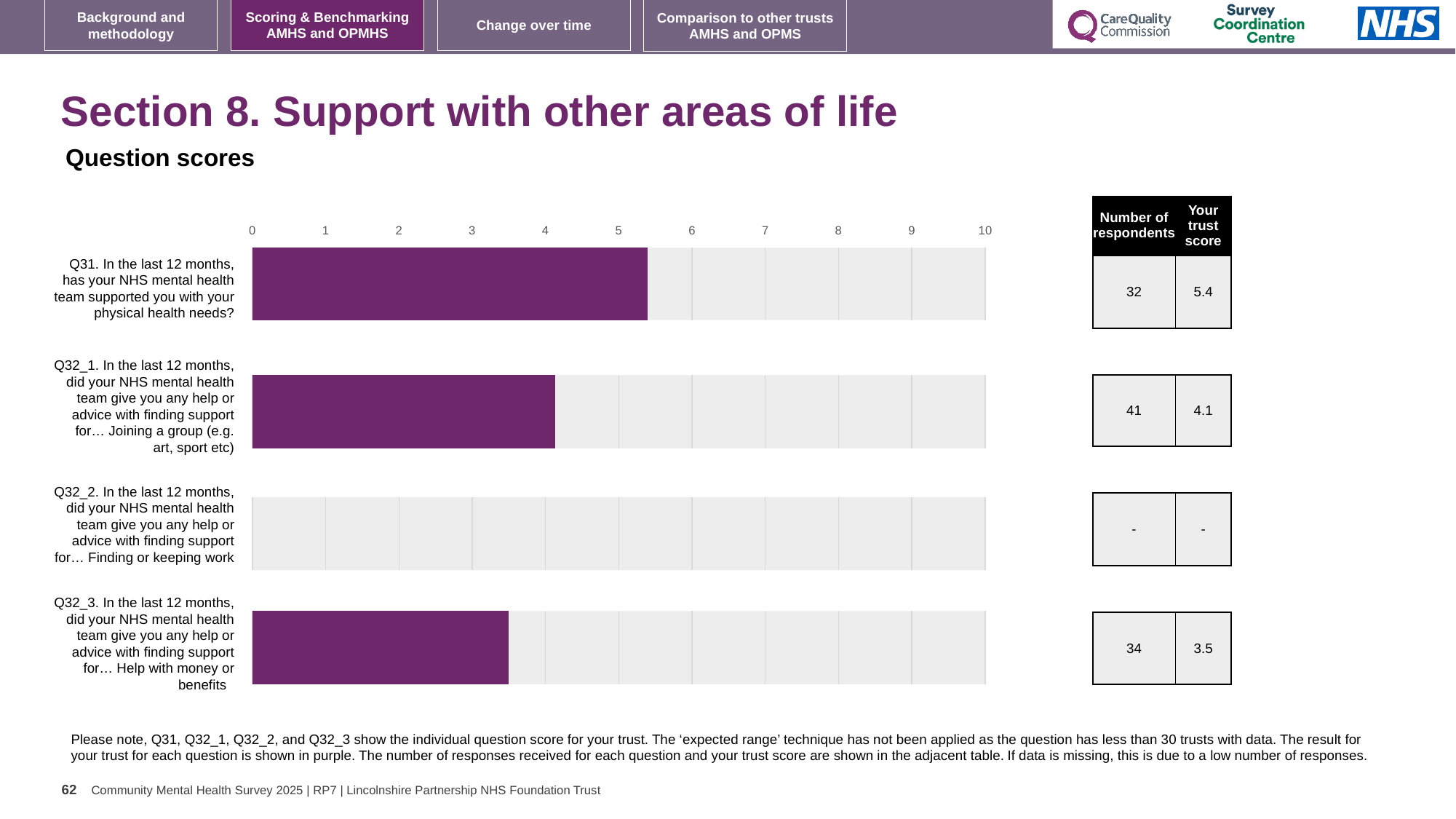
Which question with a plotted bar has the lowest trust score? Q32_3 What is the trust score for Q31 (supported you with your physical health needs)? 5.4 What is the trust score for Q32_1 (help or advice with joining a group)? 4.1 What kind of chart is shown on the slide? Bar chart Which has a higher trust score, Q32_1 or Q32_3? Q32_1 Which question has the highest trust score on the chart? Q31 Which question has no bar plotted and shows '-' in the table? Q32_2 How many questions are listed on the chart? 4 What is the difference between the trust scores for Q31 and Q32_3? 1.9 Is the value for Q31 greater or less than 5? greater How many respondents answered Q32_1? 41 What is the trust score for Q32_3 (help with money or benefits)? 3.5